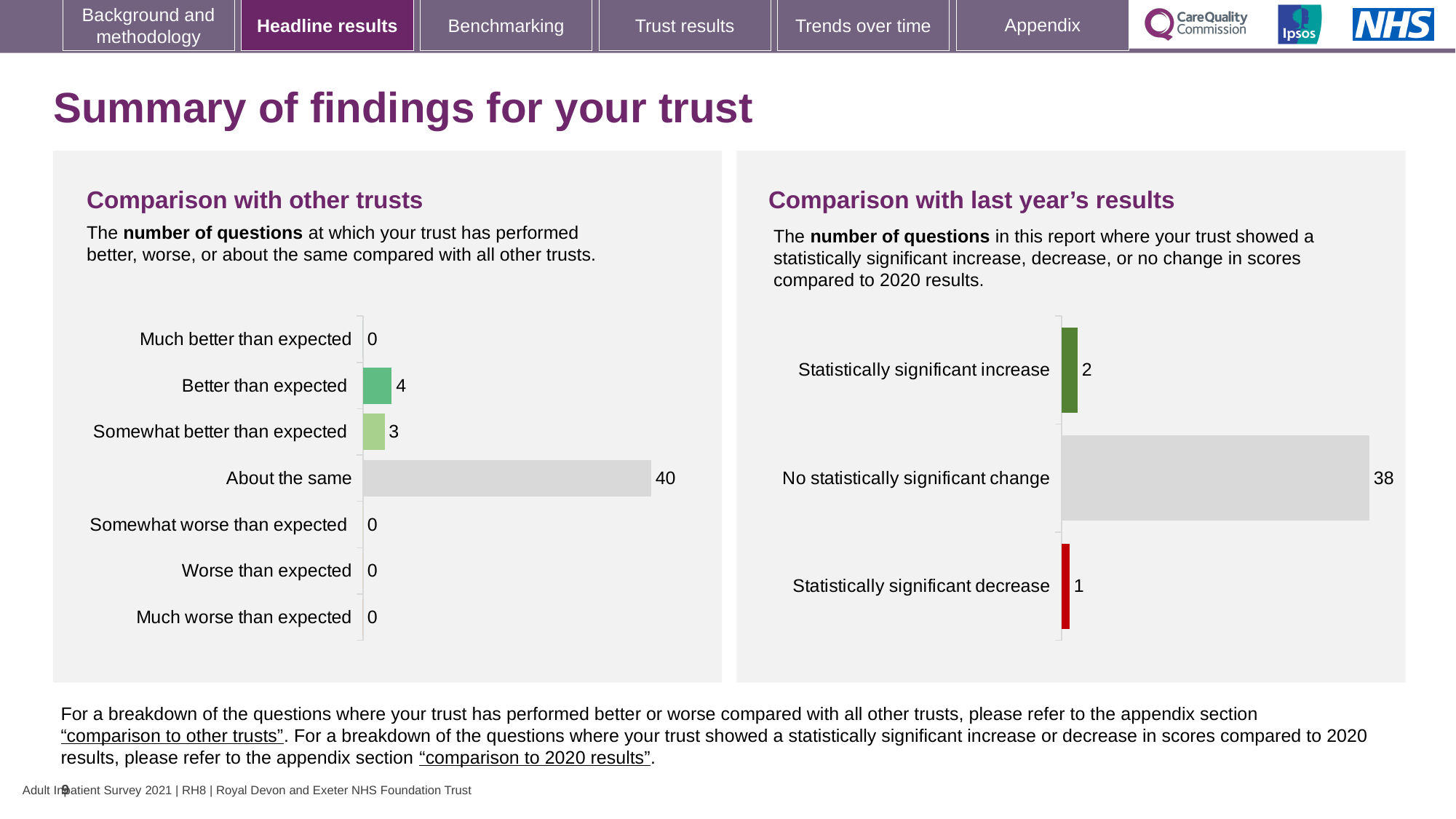
In the 'Comparison with other trusts' chart, which category has the highest value? About the same In the 'Comparison with other trusts' chart, what is the value for 'Better than expected'? 4 In the 'Comparison with last year's results' chart, what is the value for 'Statistically significant decrease'? 1 In the 'Comparison with other trusts' chart, what is the value for 'Somewhat better than expected'? 3 In the 'Comparison with other trusts' chart, what is the difference between 'About the same' and 'Better than expected'? 36 In the 'Comparison with last year's results' chart, what is the value for 'No statistically significant change'? 38 In the 'Comparison with other trusts' chart, how many categories are shown? 7 In the 'Comparison with last year's results' chart, which category has the lowest value? Statistically significant decrease In the 'Comparison with other trusts' chart, which is larger: 'Better than expected' or 'Somewhat better than expected'? Better than expected In the 'Comparison with last year's results' chart, what is the difference between 'Statistically significant increase' and 'Statistically significant decrease'? 1 In the 'Comparison with other trusts' chart, what is the value for 'About the same'? 40 What type of chart is the 'Comparison with last year's results' chart? Bar chart